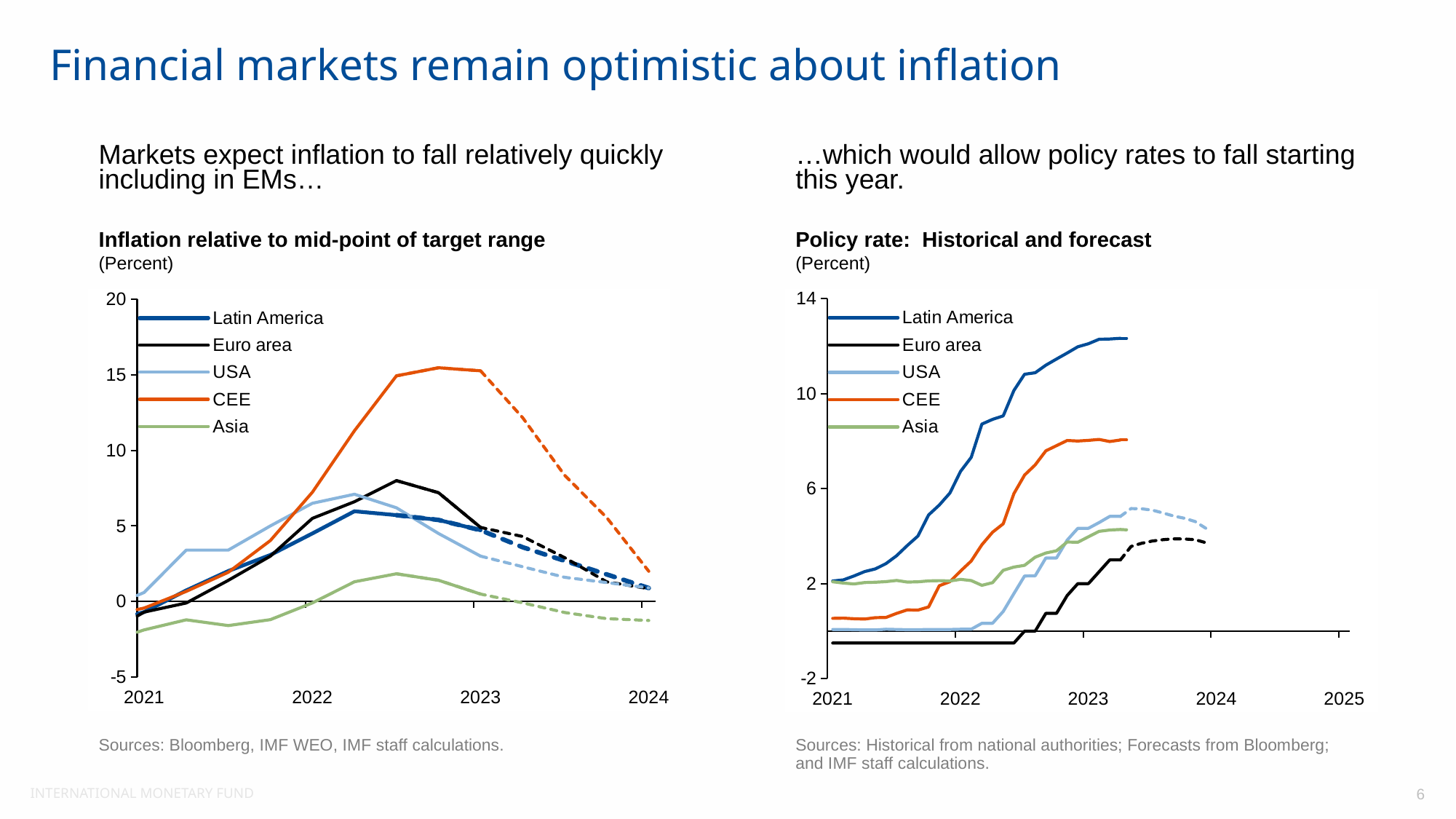
What kind of chart is the left chart, 'Inflation relative to mid-point of target range'? line chart In the left chart, 'Inflation relative to mid-point of target range', does the CEE line rise or fall between 2023 and 2024? fall In the right chart, 'Policy rate: Historical and forecast', is the value for Latin America at the start of 2023 greater or less than 10? greater In the right chart, 'Policy rate: Historical and forecast', which is larger at the start of 2023: the value for CEE or the value for Asia? CEE In the right chart, 'Policy rate: Historical and forecast', does the Latin America line rise or fall between 2021 and 2023? rise In the right chart, 'Policy rate: Historical and forecast', which series has the lowest value in 2021? Euro area In the left chart, 'Inflation relative to mid-point of target range', is the value for Asia at the start of 2021 greater or less than 0? less What unit is shown under the title of the left chart, 'Inflation relative to mid-point of target range'? Percent How many series does the legend of the right chart, 'Policy rate: Historical and forecast', list? 5 In the left chart, 'Inflation relative to mid-point of target range', is the peak value for CEE greater or less than 10? greater In the left chart, 'Inflation relative to mid-point of target range', which series reaches the highest value? CEE In the right chart, 'Policy rate: Historical and forecast', which series reaches the highest value? Latin America